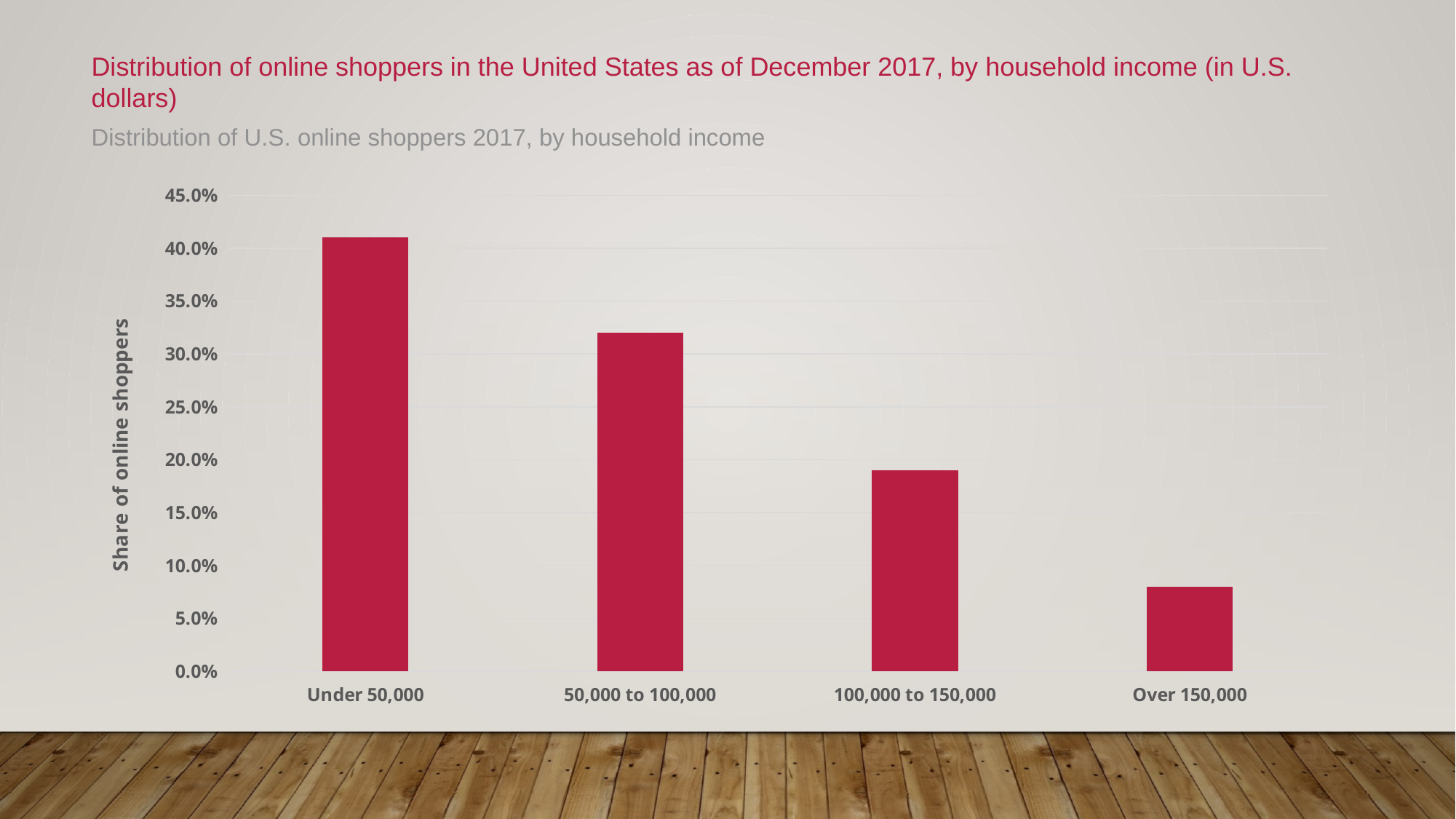
Is the share of online shoppers for 100,000 to 150,000 greater or less than 20.0%? less Do the values rise or fall as household income increases along the x axis? fall Is the share of online shoppers for Under 50,000 greater or less than 40.0%? greater What is the label of the vertical axis? Share of online shoppers How many household income categories are shown on the chart? 4 Which household income category has the lowest share of online shoppers? Over 150,000 Is the share of online shoppers for 50,000 to 100,000 greater or less than 30.0%? greater What kind of chart is shown on the slide? bar chart Which household income category has the highest share of online shoppers? Under 50,000 Which has a larger share of online shoppers, 50,000 to 100,000 or 100,000 to 150,000? 50,000 to 100,000